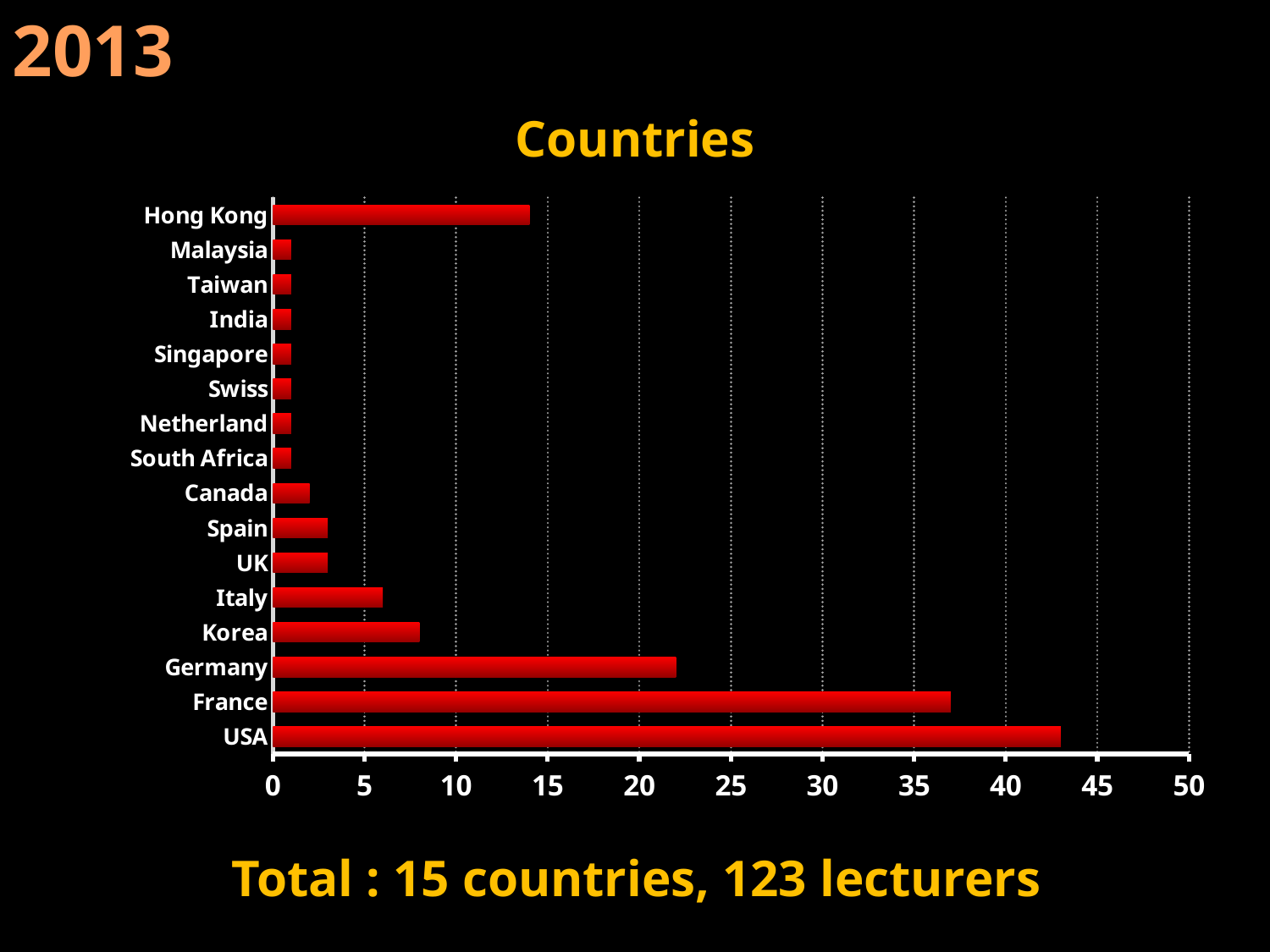
Is the value for USA greater or less than 40? greater Is the value for Korea greater or less than 10? less What is the maximum value shown on the horizontal axis? 50 What is the title of the chart? Countries Is the value for Germany greater or less than 25? less Which has a larger value, Hong Kong or Korea? Hong Kong How many countries are listed on the chart's vertical axis? 16 What kind of chart is shown on the slide? bar chart Which country has the highest value in the chart? USA Which has a larger value, France or Germany? France